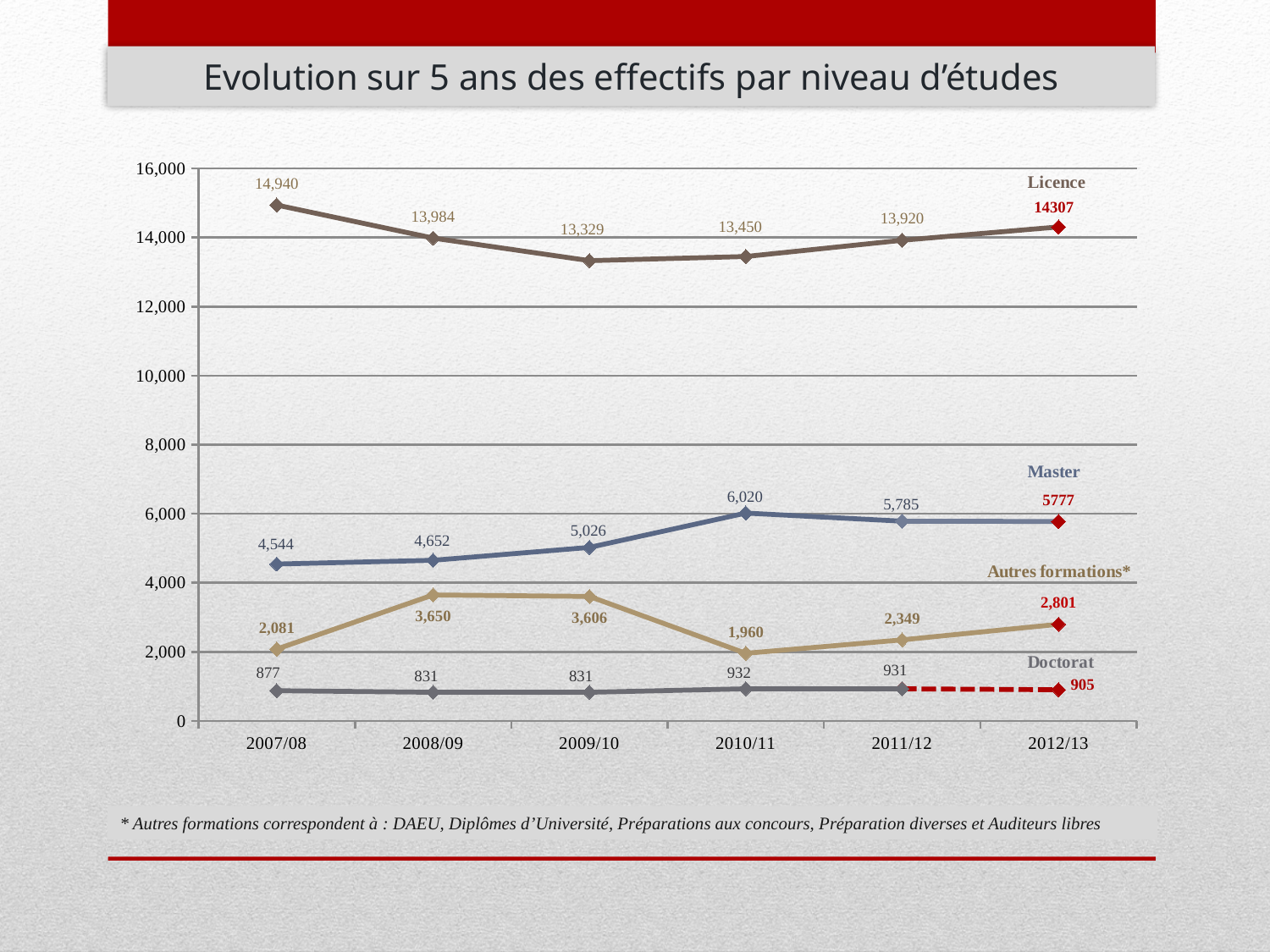
What is the Autres formations* value for 2009/10? 3,606 What is the Licence value for 2007/08? 14,940 What kind of chart is shown on the slide? line chart What is the Master value for 2010/11? 6,020 What is the Doctorat value for 2012/13? 905 How many years are shown on the x axis? 6 How many series are plotted on the chart? 4 What is the title of the slide? Evolution sur 5 ans des effectifs par niveau d'études Which is larger: the Autres formations* value for 2011/12 or for 2012/13? 2012/13 In which year is the Licence series lowest? 2009/10 What is the difference between the Master values for 2010/11 and 2011/12? 235 In which year is the Autres formations* series highest? 2008/09